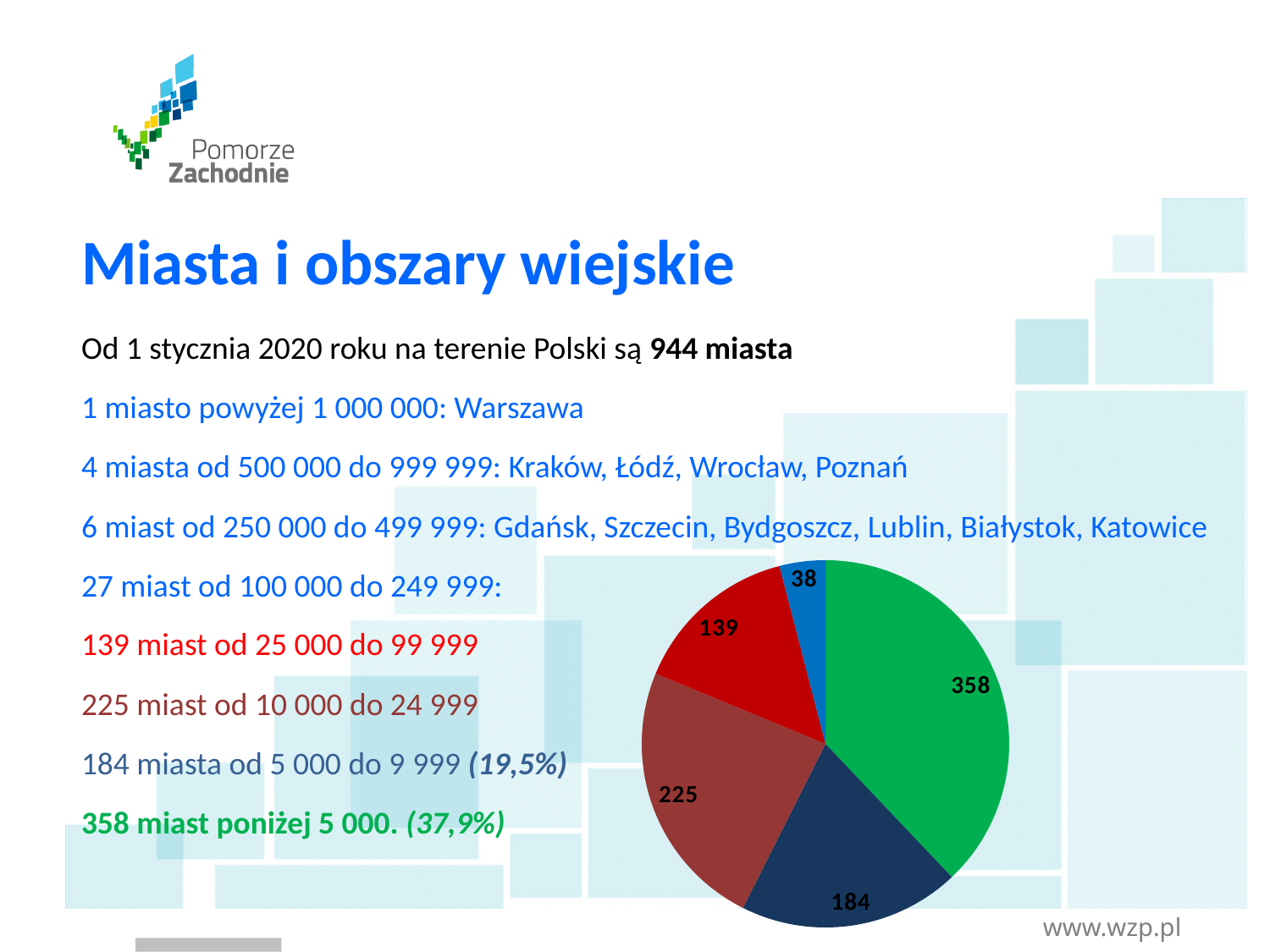
What is the difference between the largest slice (358) and the slice labelled 184? 174 What share of the pie does the slice labelled 184 represent, as stated on the slide? 19,5% What is the value shown on the red slice of the pie chart? 139 What kind of chart is shown on the slide? pie chart How many slices does the pie chart have? 5 What is the difference between the slices labelled 225 and 139? 86 Which slice of the pie chart has the largest value? 358 Which is larger in the pie chart: the slice labelled 225 or the slice labelled 184? 225 Which slice of the pie chart has the smallest value? 38 What is the value shown on the green slice of the pie chart? 358 What is the value shown on the dark navy slice of the pie chart? 184 What share of the pie does the slice labelled 358 represent, as stated on the slide? 37,9%